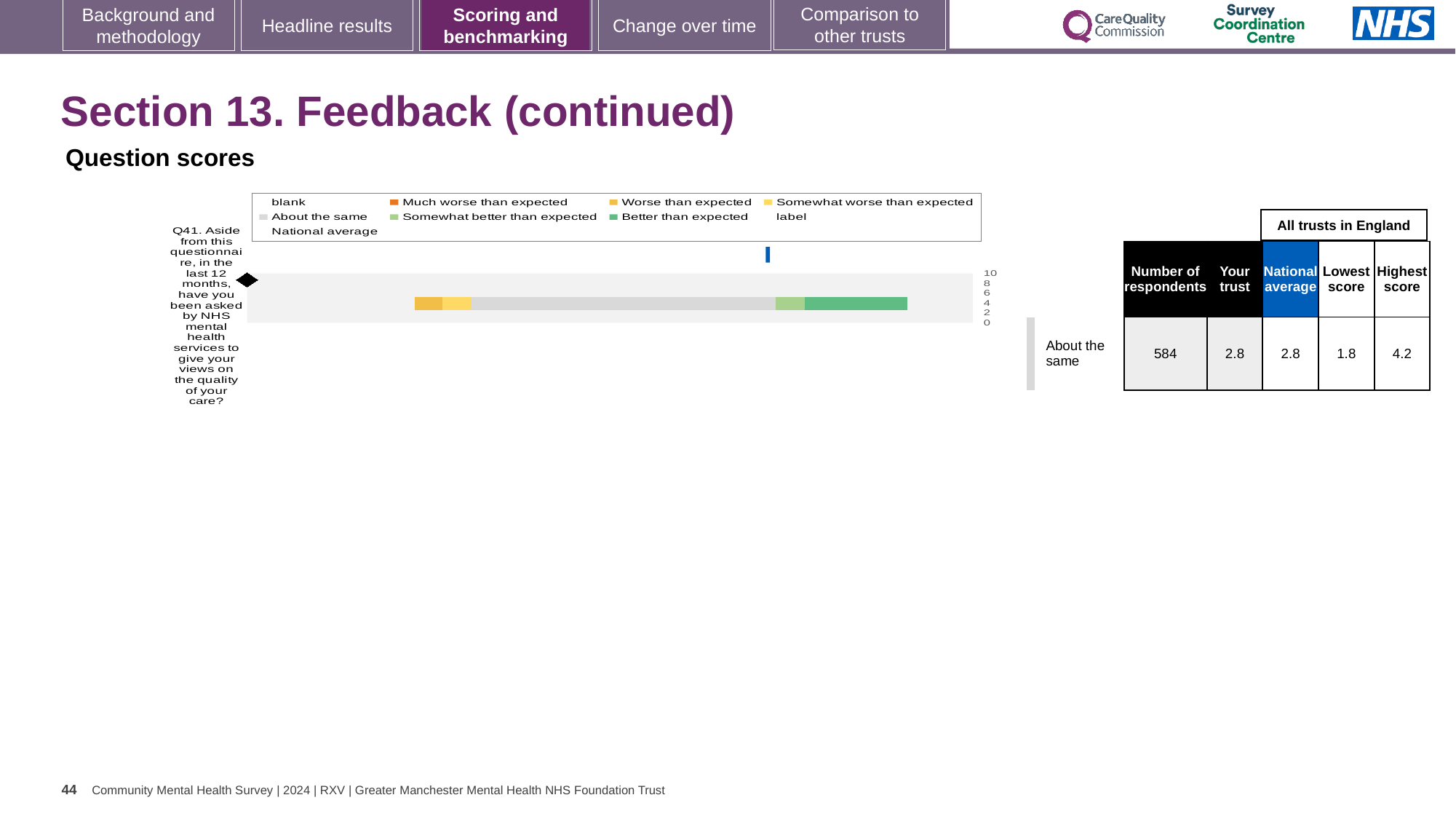
How many questions (categories) are plotted in the chart? 1 According to the table next to the chart, what is the national average score for Q41? 2.8 What is the difference between the highest score and the lowest score for Q41 shown in the table? 2.4 Which is larger for Q41: the highest score or the 'Your trust' score? Highest score According to the table next to the chart, what is the highest score among all trusts in England for Q41? 4.2 According to the table next to the chart, how many respondents answered Q41? 584 According to the table next to the chart, what is the lowest score among all trusts in England for Q41? 1.8 Which question number is plotted in the chart? Q41 What kind of chart is shown on the slide for Q41? bar chart In the chart legend, what colour represents 'Better than expected'? green What benchmarking category is the trust's Q41 score placed in, as labelled beside the chart? About the same According to the table next to the chart, what is the 'Your trust' score for Q41? 2.8